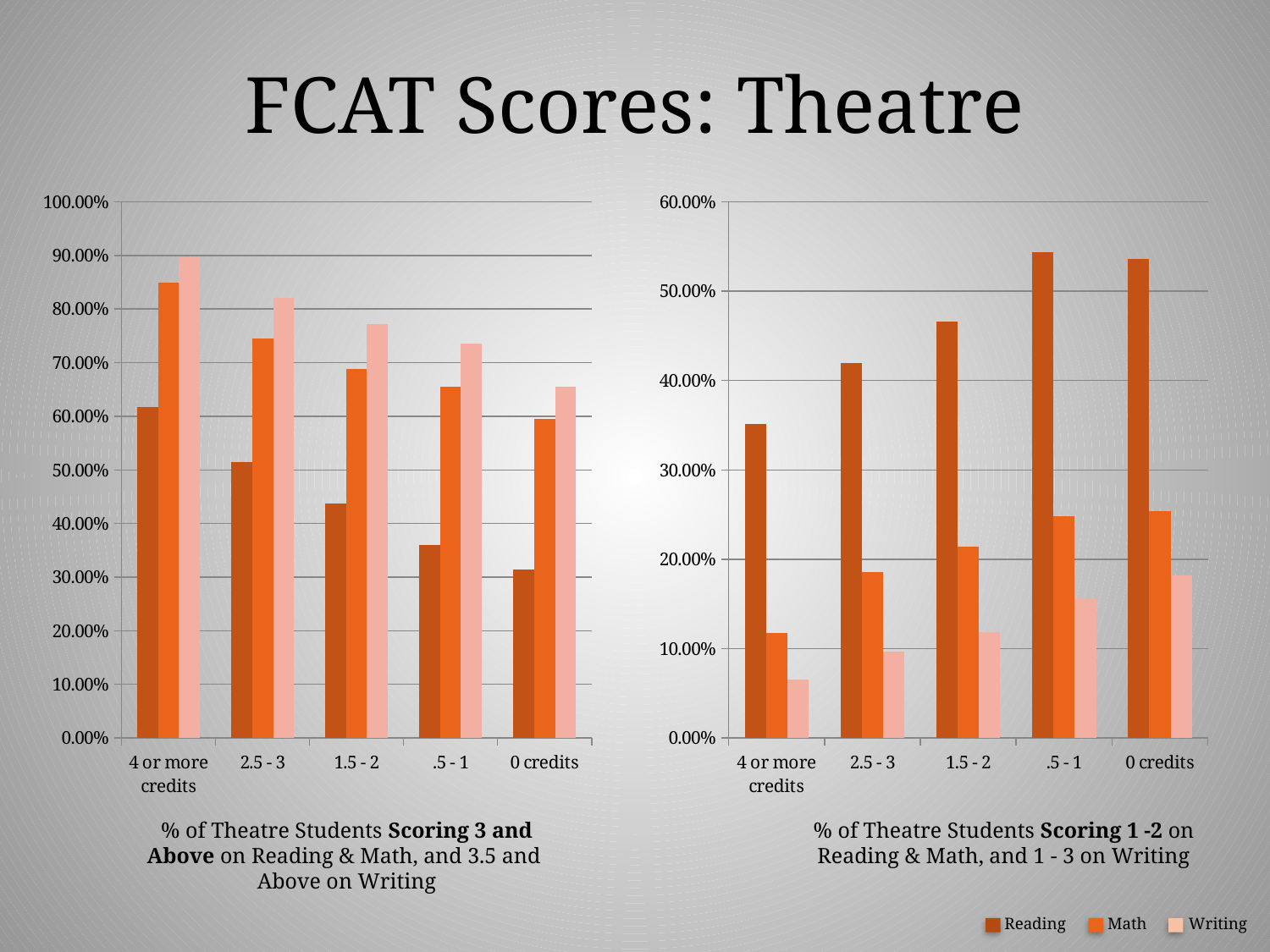
In the right chart, '% of Theatre Students Scoring 1-2', is the Reading value for '.5 - 1' greater or less than 50.00%? greater How many series does the legend list for the charts on this slide? 3 In the left chart, '% of Theatre Students Scoring 3 and Above', which series has the highest value for '4 or more credits'? Writing In the right chart, '% of Theatre Students Scoring 1-2', which credit category has the lowest Reading value? 4 or more credits In the left chart, '% of Theatre Students Scoring 3 and Above', is the Reading value for '4 or more credits' greater or less than 50.00%? greater How many credit categories are shown on the x axis of the right chart, '% of Theatre Students Scoring 1-2'? 5 What kind of chart is the left chart, '% of Theatre Students Scoring 3 and Above'? bar chart In the left chart, '% of Theatre Students Scoring 3 and Above', do the Reading values rise or fall moving from '4 or more credits' to '0 credits'? fall In the left chart, '% of Theatre Students Scoring 3 and Above', is the Math value for '0 credits' greater or less than 50.00%? greater In the left chart, '% of Theatre Students Scoring 3 and Above', which is larger: the Reading value for '2.5 - 3' or the Reading value for '0 credits'? 2.5 - 3 In the right chart, '% of Theatre Students Scoring 1-2', do the Writing values rise or fall moving from '4 or more credits' to '0 credits'? rise